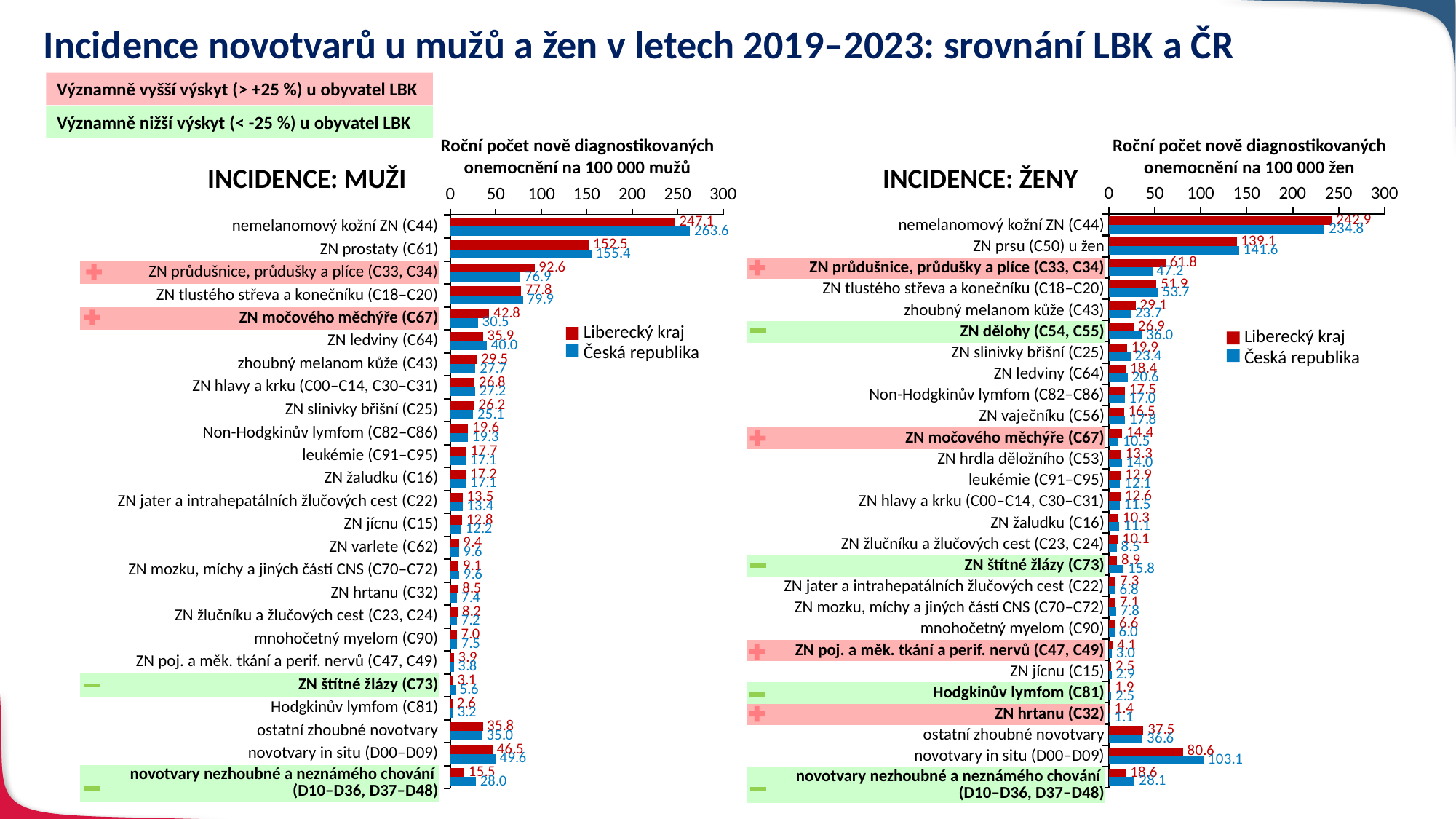
What type of chart is the INCIDENCE: ŽENY chart? bar chart In the INCIDENCE: MUŽI chart, what is the value for Česká republika for ZN prostaty (C61)? 155.4 In the INCIDENCE: ŽENY chart, what is the value for Česká republika for novotvary in situ (D00–D09)? 103.1 In the INCIDENCE: MUŽI chart, what is the difference between the Liberecký kraj and Česká republika values for ZN močového měchýře (C67)? 12.3 In the INCIDENCE: MUŽI chart, what is the value for Liberecký kraj for nemelanomový kožní ZN (C44)? 247.1 In the INCIDENCE: MUŽI chart, is the Liberecký kraj value for ZN průdušnice, průdušky a plíce (C33, C34) greater or less than 50? greater How many series does the legend of the INCIDENCE: MUŽI chart list? 2 In the INCIDENCE: ŽENY chart, what is the difference between the Česká republika and Liberecký kraj values for novotvary in situ (D00–D09)? 22.5 In the INCIDENCE: MUŽI chart, which category has the highest value for Liberecký kraj? nemelanomový kožní ZN (C44) In the INCIDENCE: ŽENY chart, which is larger for ZN dělohy (C54, C55): Liberecký kraj or Česká republika? Česká republika In the INCIDENCE: ŽENY chart, which category has the lowest value for Česká republika? ZN hrtanu (C32) In the INCIDENCE: ŽENY chart, what is the value for Liberecký kraj for ZN prsu (C50) u žen? 139.1